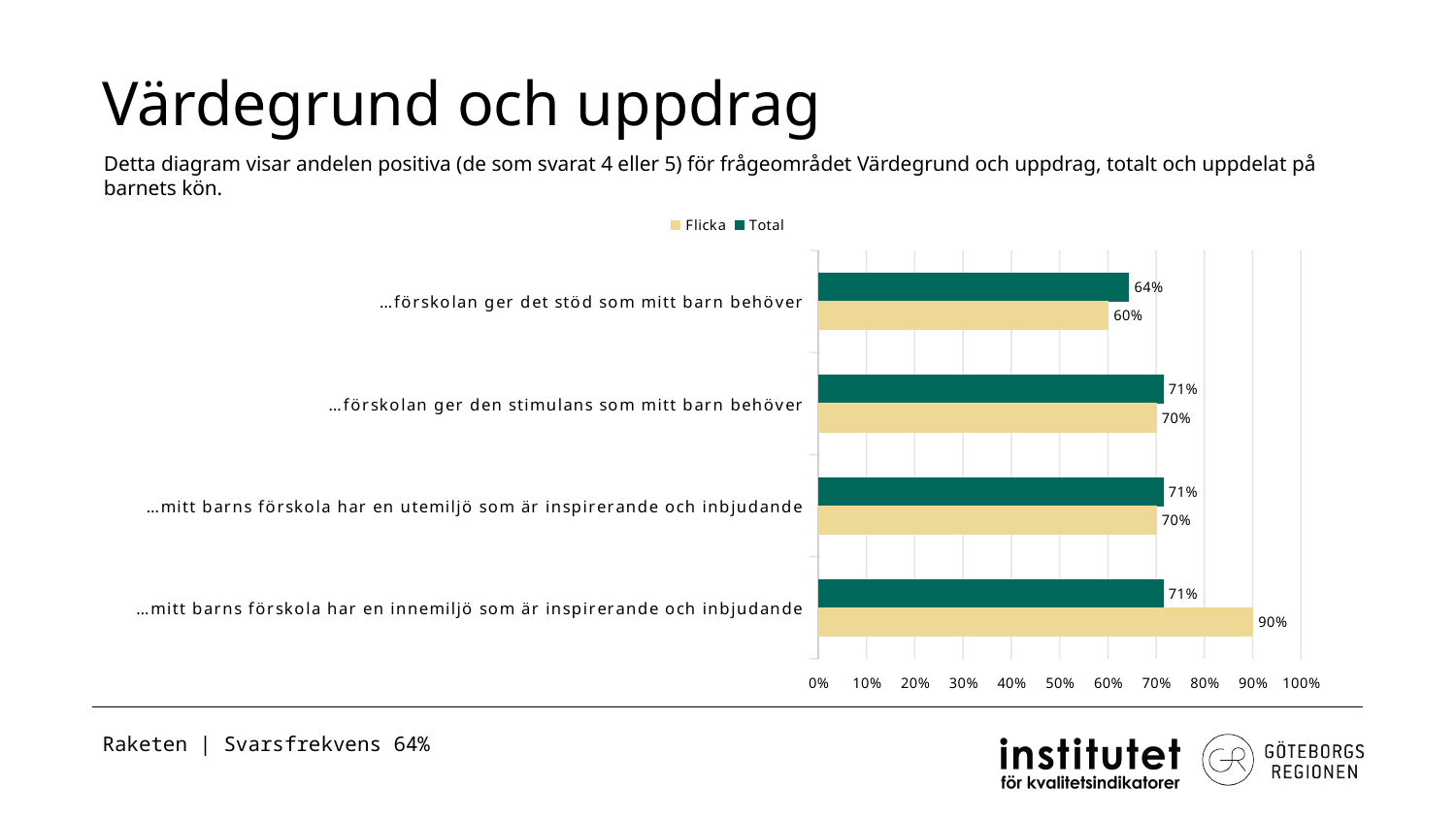
Which category has the highest Flicka value? …mitt barns förskola har en innemiljö som är inspirerande och inbjudande For "…mitt barns förskola har en innemiljö som är inspirerande och inbjudande", which is larger, the Flicka value or the Total value? Flicka What kind of chart is shown on the slide? Bar chart What is the Total value for "…mitt barns förskola har en utemiljö som är inspirerande och inbjudande"? 71% What is the Flicka value for "…mitt barns förskola har en innemiljö som är inspirerande och inbjudande"? 90% How many categories are shown in the chart? 4 How many series does the legend list? 2 What is the Flicka value for "…förskolan ger den stimulans som mitt barn behöver"? 70% What is the difference between the Total and Flicka values for "…förskolan ger det stöd som mitt barn behöver"? 4 percentage points What is the Total value for "…förskolan ger det stöd som mitt barn behöver"? 64% Which category has the lowest Total value? …förskolan ger det stöd som mitt barn behöver What is the difference between the Flicka and Total values for "…mitt barns förskola har en innemiljö som är inspirerande och inbjudande"? 19 percentage points